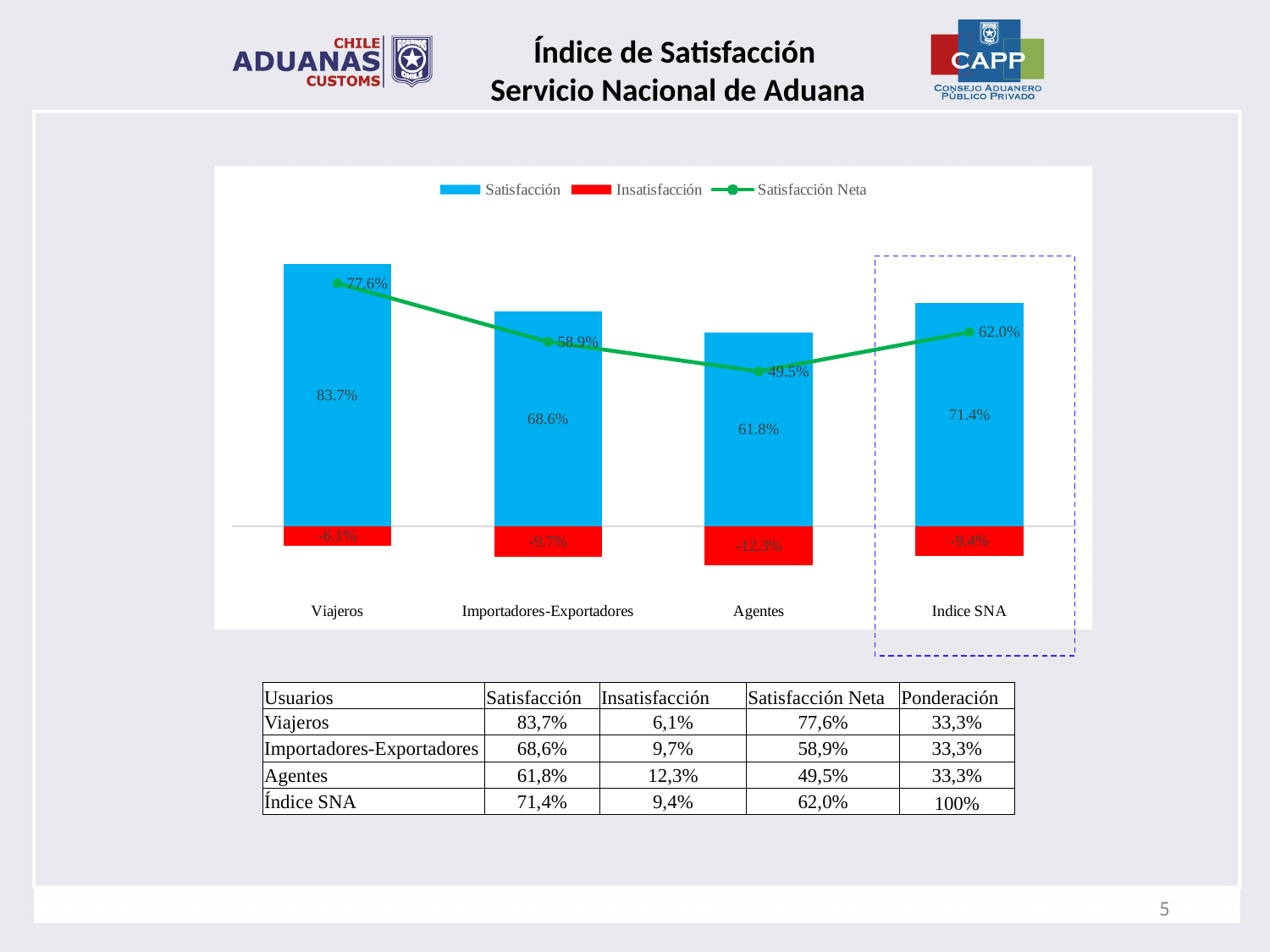
Which category has the highest Satisfacción value? Viajeros What is the Satisfacción value for Indice SNA? 71.4% What is the Insatisfacción value for Importadores-Exportadores? -9.7% What kind of chart is shown on the slide? Bar chart with a line Which category has the lowest Satisfacción Neta value? Agentes How many series does the chart legend list? 3 What is the difference between the Satisfacción values for Viajeros and Agentes? 21.9% What is the Satisfacción Neta value for Agentes? 49.5% Which series is drawn as a green line in the chart? Satisfacción Neta Which is larger, the Satisfacción Neta for Importadores-Exportadores or for Indice SNA? Indice SNA How many categories are shown on the x axis of the chart? 4 What is the Satisfacción value for Viajeros? 83.7%